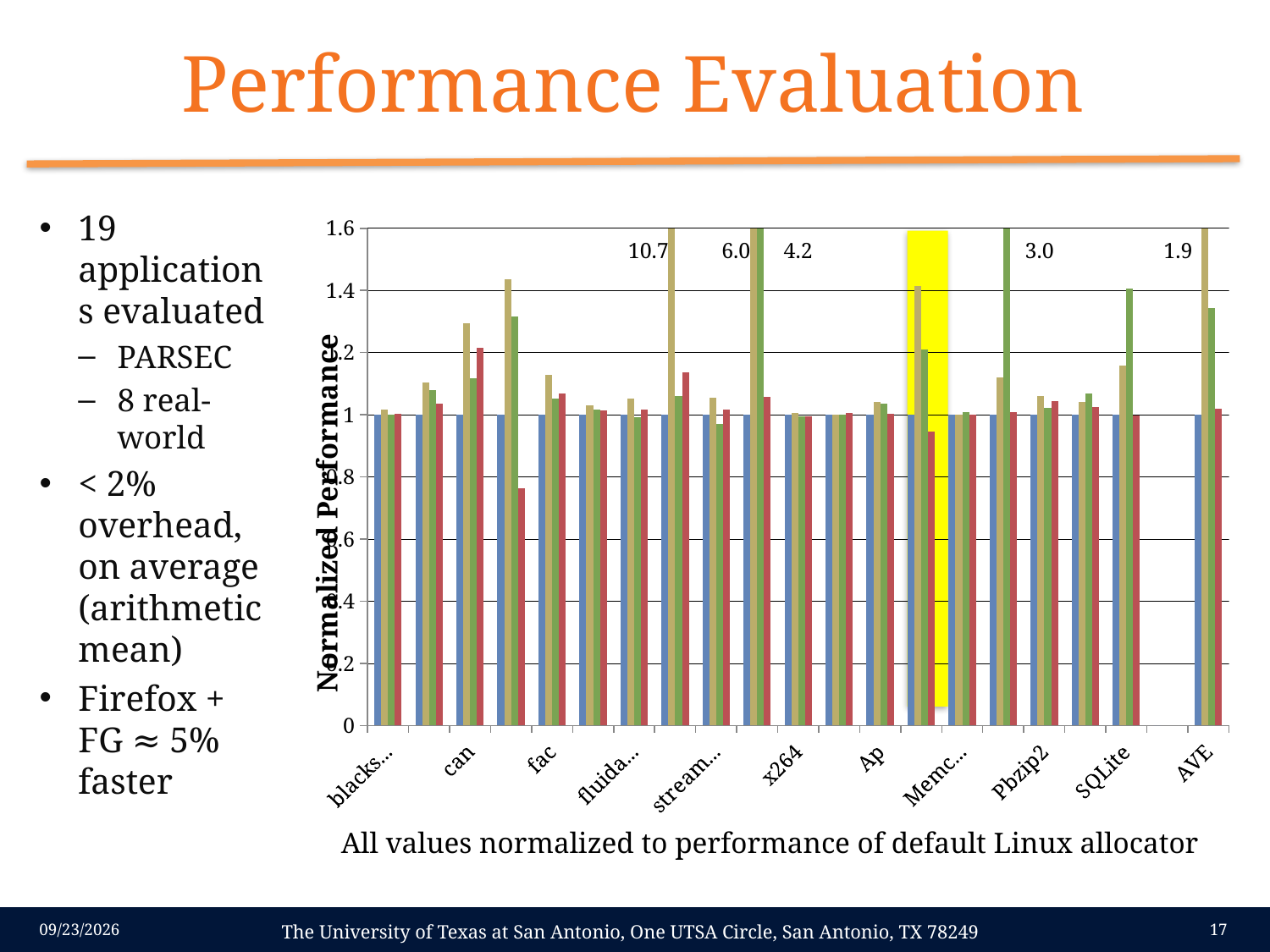
What is the highest tick value shown on the vertical axis? 1.6 What value is printed for the tallest bar in the AVE group? 1.9 What is the title of the vertical axis of the chart? Normalized Performance Which printed data label is larger, 6.0 or 4.2? 6.0 What is the difference between the printed data labels 10.7 and 1.9? 8.8 What is the highest value printed as a data label on the chart? 10.7 What is the lowest value printed as a data label on the chart? 1.9 Is the tan bar for blacks... greater or less than 1.2? less Is the green bar for AVE greater or less than 1.2? greater What kind of chart is shown on the slide? bar chart What is the difference between the printed data labels 6.0 and 4.2? 1.8